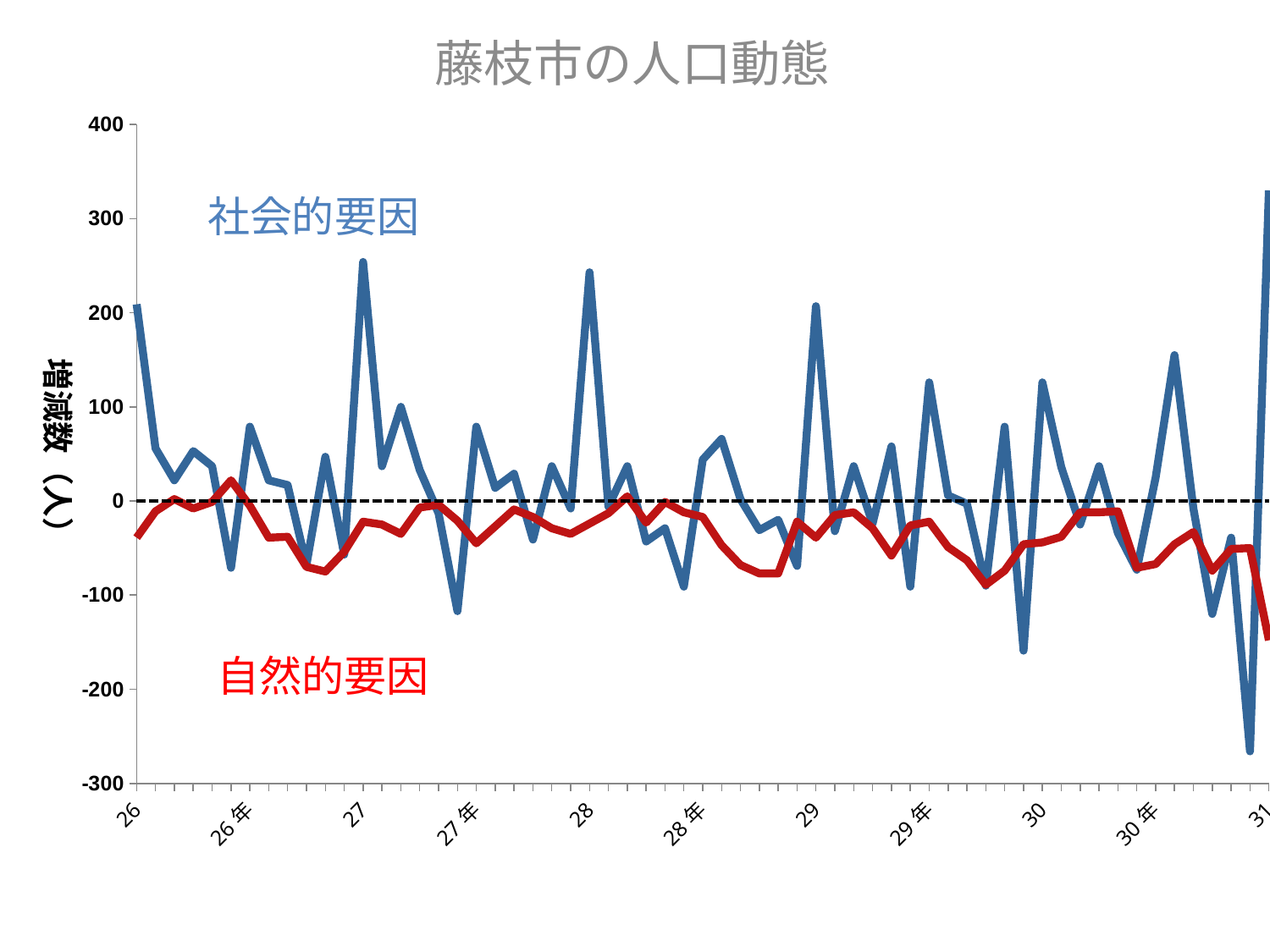
Is the value of 社会的要因 at 28 greater or less than 200? greater Is the value of 社会的要因 at 31 greater or less than 300? greater At 27, which series has the larger value, 社会的要因 or 自然的要因? 社会的要因 Which series reaches the highest value anywhere on the chart? 社会的要因 Which colour is used for the 社会的要因 line? blue What is the title of the chart? 藤枝市の人口動態 How many data series are plotted on the chart? 2 Is the value of 自然的要因 at 31 greater or less than -100? less What kind of chart is shown on the slide? line chart Does the 自然的要因 line generally rise or fall from 26 to 31? fall